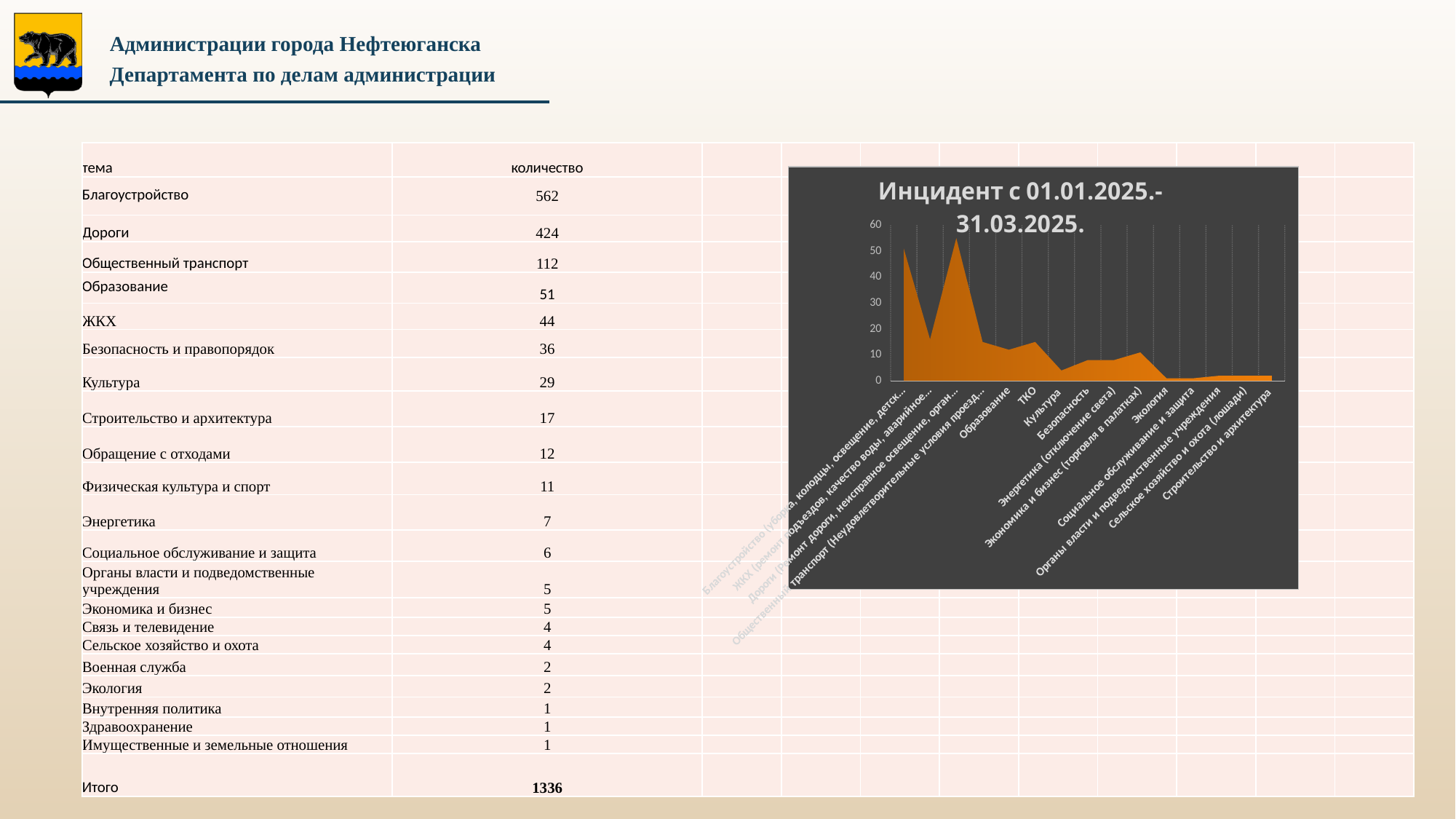
In the chart, which is larger: the value for Дороги or the value for ТКО? Дороги Do the values in the chart generally rise or fall from left to right along the x axis? Fall What is the title of the chart? Инцидент с 01.01.2025.-31.03.2025. Is the value for Образование in the chart greater or less than 20? less Is the value for Дороги in the chart greater or less than 50? greater In the chart, which is larger: the value for Благоустройство or the value for Образование? Благоустройство What kind of chart is shown on the slide? Area chart Which category has the highest value in the chart? Дороги (ремонт дороги, неисправное освещение, орган...) Is the value for Благоустройство in the chart greater or less than 40? greater How many categories are plotted along the x axis of the chart? 15